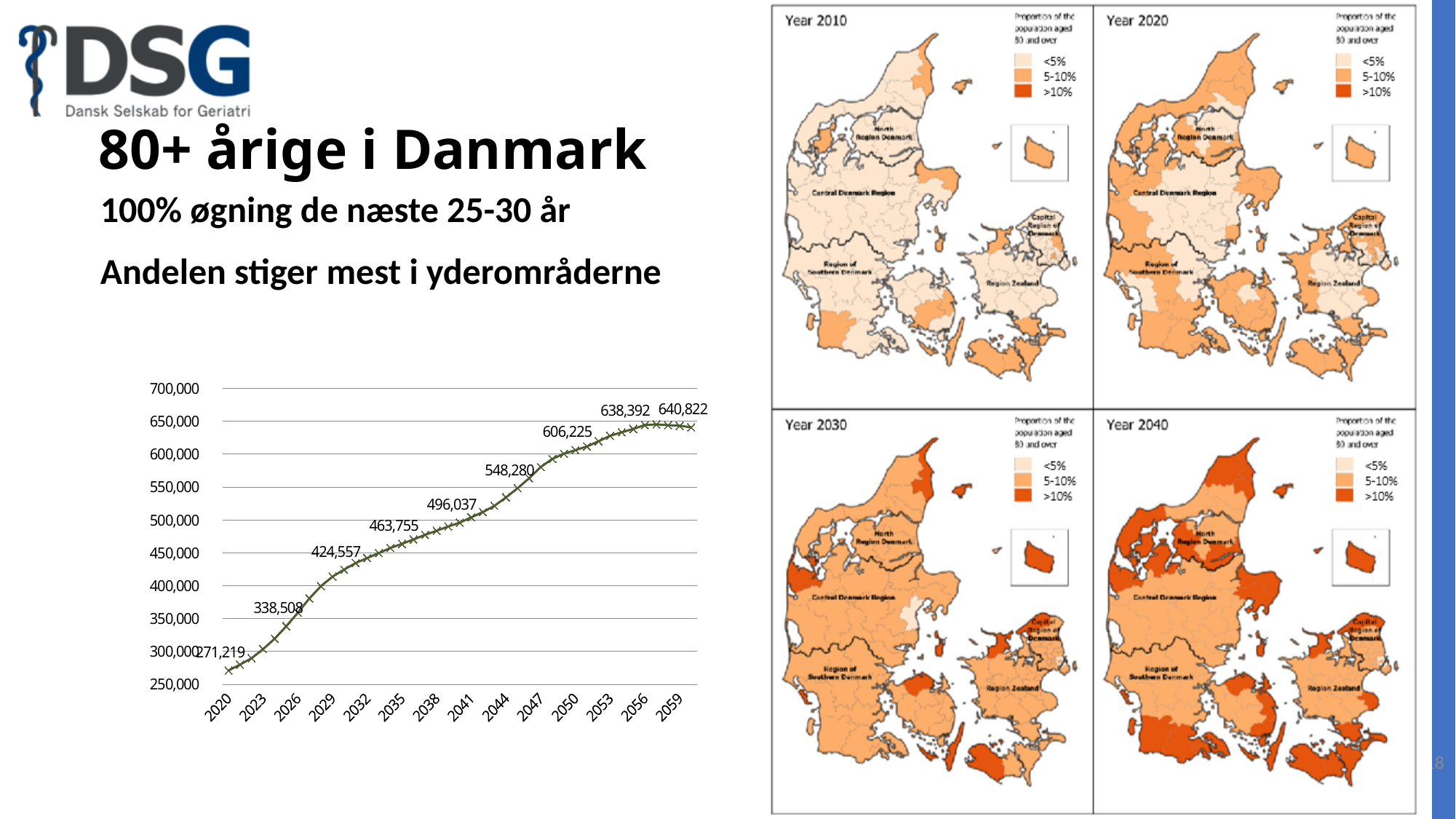
On the line chart, is the value for 2050 greater or less than 550,000? greater How many data labels are printed on the line chart? 9 On the line chart, is the value for 2023 greater or less than 350,000? less On the line chart, what is the difference between the labelled values 606,225 and 548,280? 57,945 On the line chart, what is the highest value labelled on the line? 640,822 On the line chart, is the value for 2029 greater or less than 350,000? greater On the line chart, what is the difference between the highest labelled value (640,822) and the value for 2020 (271,219)? 369,603 On the line chart, do the values rise or fall from 2020 to 2059? rise What kind of chart is shown on the left side of the slide? line chart On the line chart, what is the value shown for 2020? 271,219 On the line chart, what is the lowest value labelled on the line? 271,219 On the line chart, which is larger: the labelled value 463,755 or the labelled value 424,557? 463,755